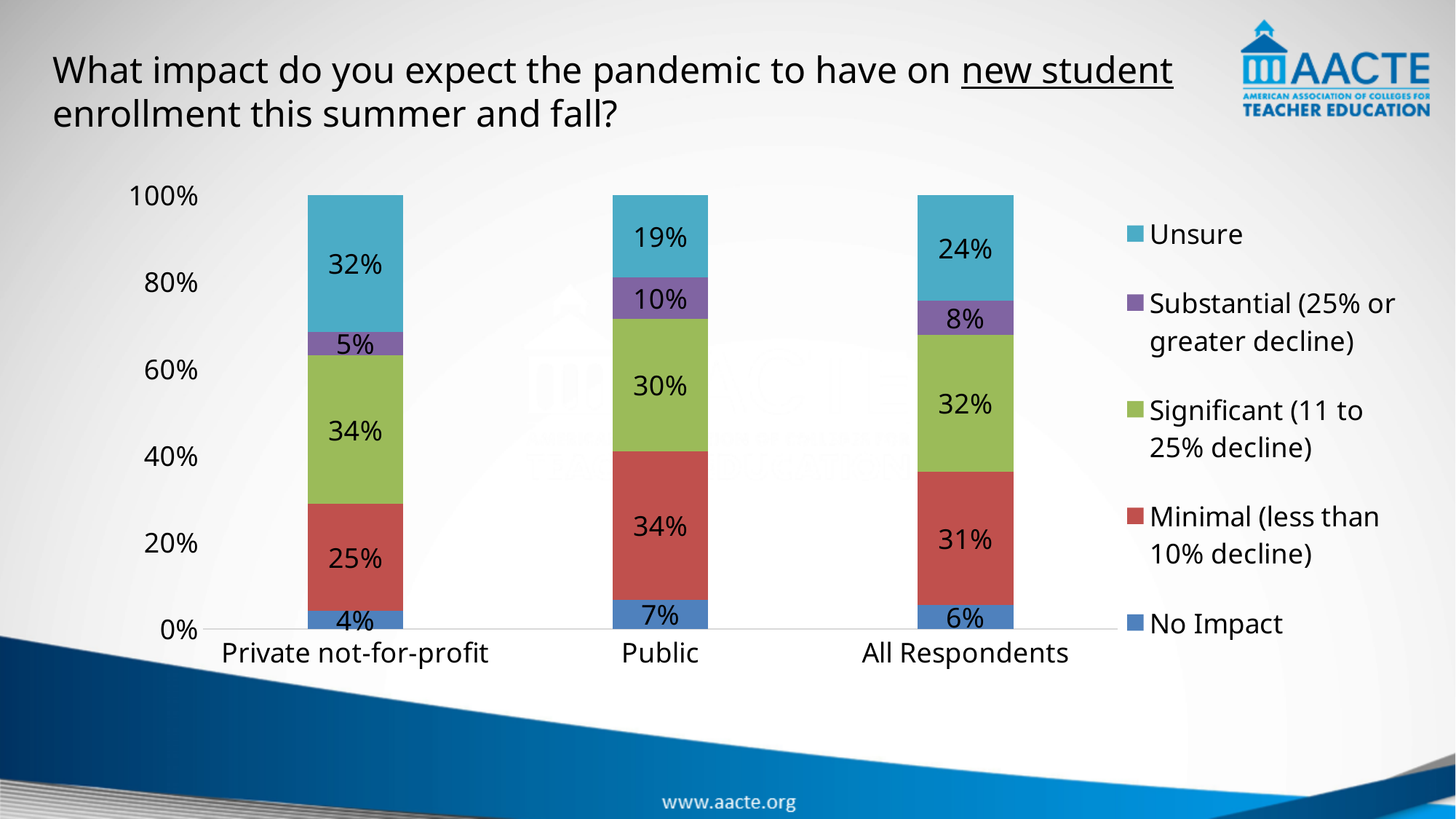
Which category has the highest Unsure percentage? Private not-for-profit How many categories are shown on the x axis? 3 What kind of chart is shown on the slide? Stacked bar chart What is the difference between the Unsure percentage for Private not-for-profit and for Public? 13% What percentage of Private not-for-profit respondents are Unsure? 32% How many series does the legend list? 5 Which is larger: the Significant (11 to 25% decline) share for Public or for All Respondents? All Respondents Which colour represents the Unsure series in the legend? Teal (light blue) What percentage of All Respondents expect No Impact? 6% Which category has the lowest No Impact percentage? Private not-for-profit What percentage of Public respondents expect a Substantial (25% or greater decline) impact? 10% What percentage of Public respondents expect a Minimal (less than 10% decline) impact? 34%